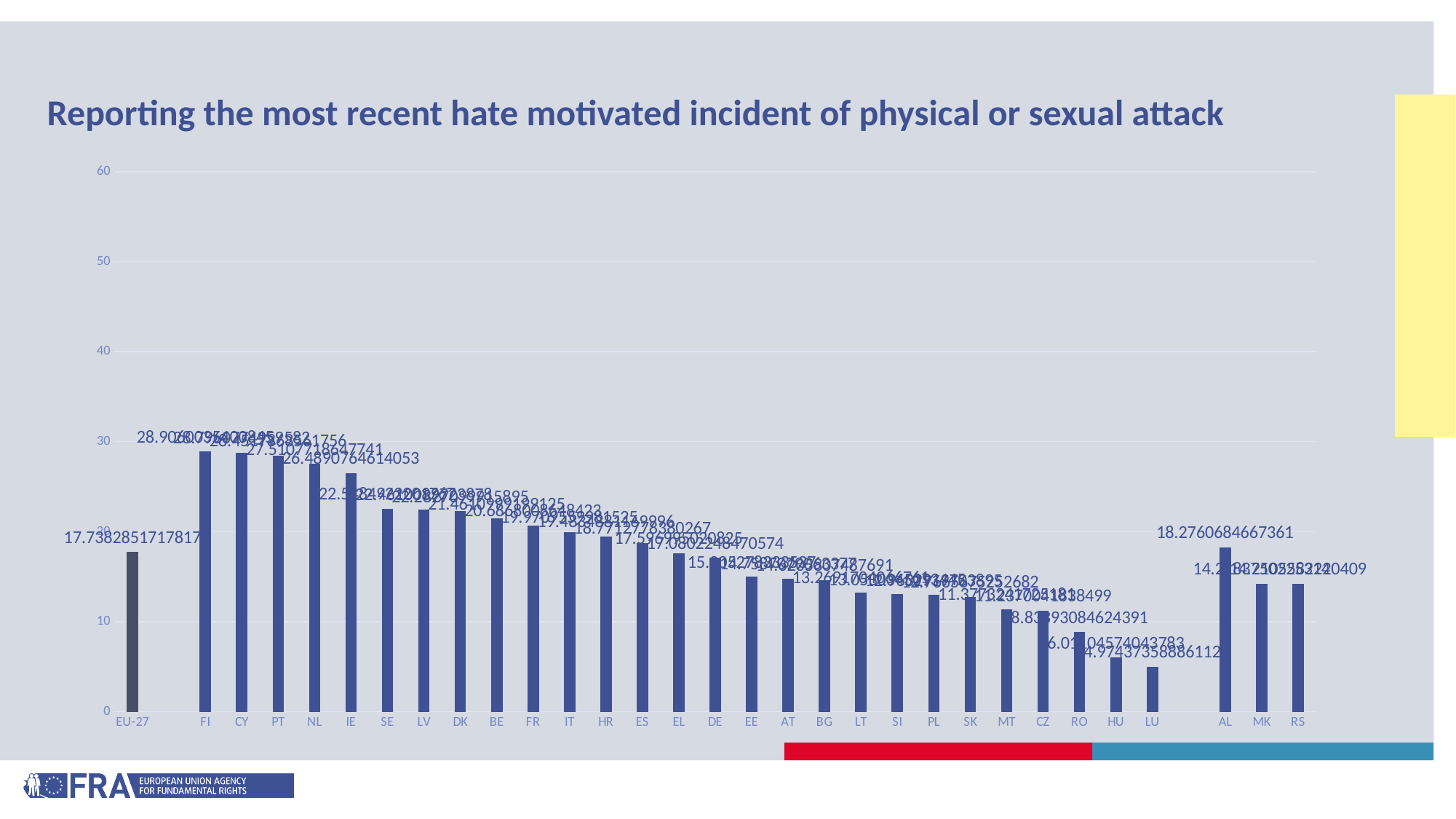
Which category has the lowest value? LU How many categories are shown on the x axis? 31 What is the title of the chart? Reporting the most recent hate motivated incident of physical or sexual attack Which is larger, the value for NL or the value for AL? NL What is the value for EU-27? 17.7382851717817 Do the values rise or fall along the x axis from FI to LU? fall What kind of chart is shown on the slide? bar chart Is the value for FI greater or less than 20? greater Is the value for HU greater or less than 10? less What is the value for AL? 18.2760684667361